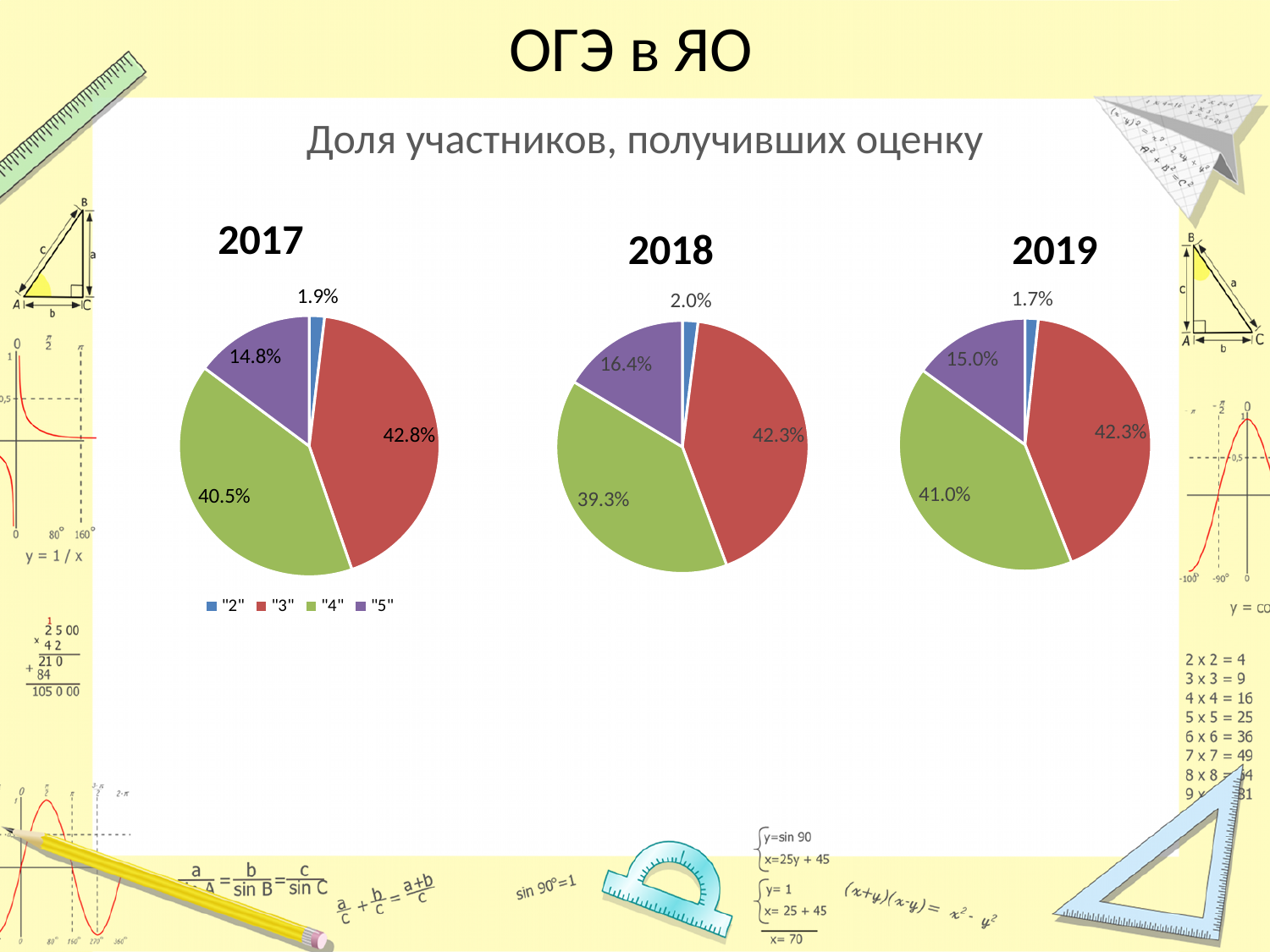
In the 2019 pie chart, what share of participants received a "2"? 1.7% In the 2018 pie chart, which grade has the smallest share? "2" In the 2017 pie chart, which is larger: the share for "4" or the share for "5"? "4" In the 2018 pie chart, what share of participants received a "5"? 16.4% How many entries does the legend list? 4 In the 2019 pie chart, what is the difference between the share for "3" and the share for "4"? 1.3% What type of chart is used for 2017, 2018 and 2019? Pie chart In the 2017 pie chart, what share of participants received a "3"? 42.8% In the 2017 pie chart, which grade has the largest share? "3" In the 2019 pie chart, what share of participants received a "4"? 41.0% Which colour represents the grade "5" in the legend? Purple How many slices does the 2018 pie chart have? 4